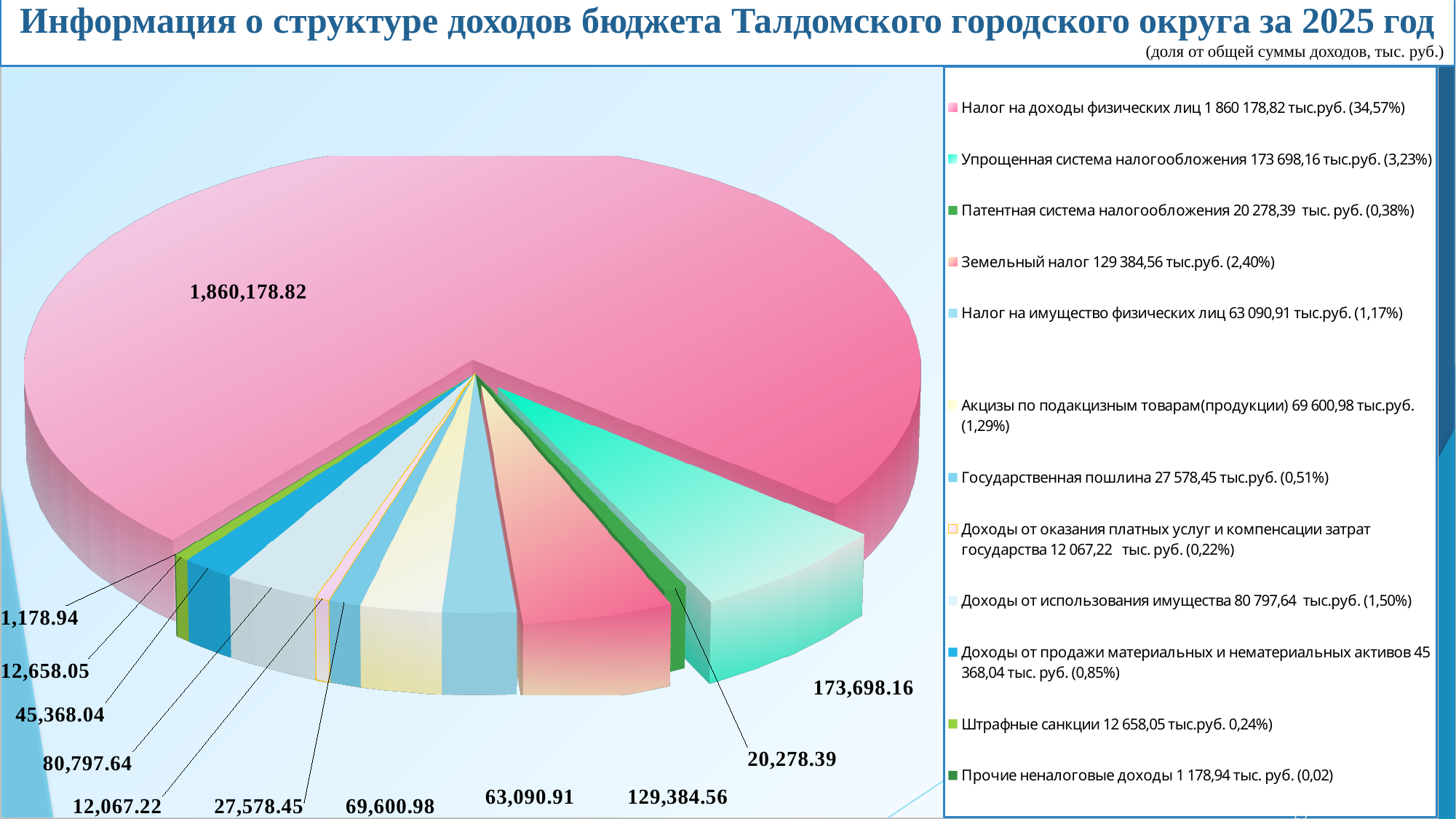
What kind of chart is shown on the slide? Pie chart What is the value for Упрощенная система налогообложения? 173,698.16 How many categories does the legend list? 12 What is the value for Земельный налог? 129,384.56 What share of total revenue does Налог на доходы физических лиц represent, according to the legend? 34,57% What is the difference between the values for Упрощенная система налогообложения and Земельный налог? 44,313.60 What is the difference between the values for Налог на имущество физических лиц and Доходы от продажи материальных и нематериальных активов? 17,722.87 What share of total revenue does Доходы от использования имущества represent, according to the legend? 1,50% What is the value for Доходы от продажи материальных и нематериальных активов? 45,368.04 Which category has the largest value? Налог на доходы физических лиц Which is larger: Доходы от использования имущества or Акцизы по подакцизным товарам(продукции)? Доходы от использования имущества Which category has the smallest value? Прочие неналоговые доходы